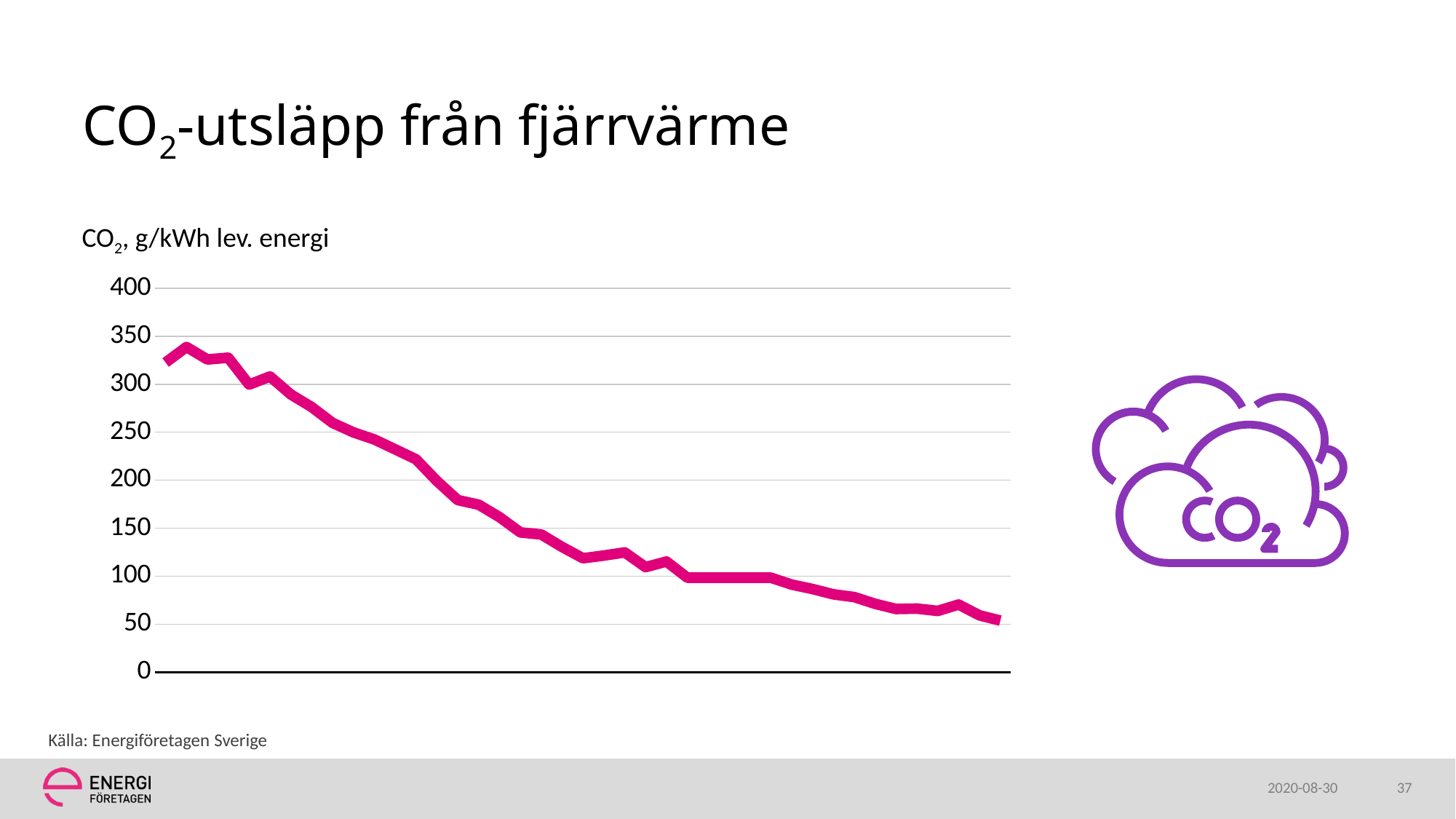
What unit label is shown above the y axis of the chart? CO2, g/kWh lev. energi Is the value at the rightmost point of the line greater or less than 100? less Is the highest point of the line greater or less than 350? less Is the lowest point of the line greater or less than 150? less Do the values in the chart generally rise or fall from left to right? fall What kind of chart is shown on the slide? line chart Is the value at the left end of the line larger or smaller than the value at the right end? larger What is the title of the slide's chart? CO2-utsläpp från fjärrvärme